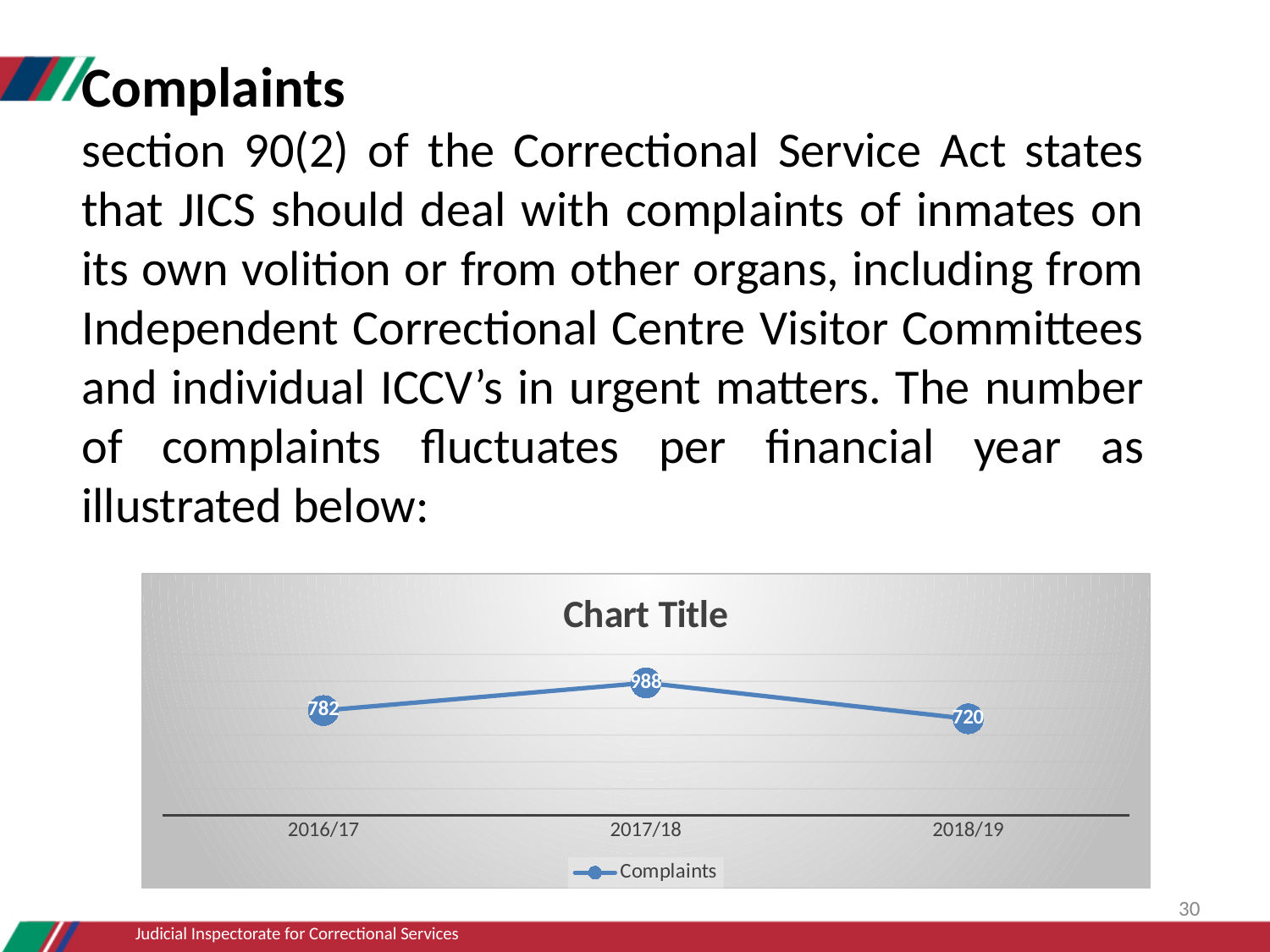
What is the name of the series shown in the chart legend? Complaints What is the number of complaints for 2018/19? 720 What is the number of complaints for 2017/18? 988 Which financial year has the lowest number of complaints? 2018/19 How many series does the legend list? 1 Which financial year has the highest number of complaints? 2017/18 How many financial years are plotted on the chart? 3 What is the difference in complaints between 2016/17 and 2018/19? 62 What is the number of complaints for 2016/17? 782 Which year had more complaints, 2016/17 or 2018/19? 2016/17 What kind of chart is shown on the slide? Line chart What is the difference in complaints between 2017/18 and 2016/17? 206